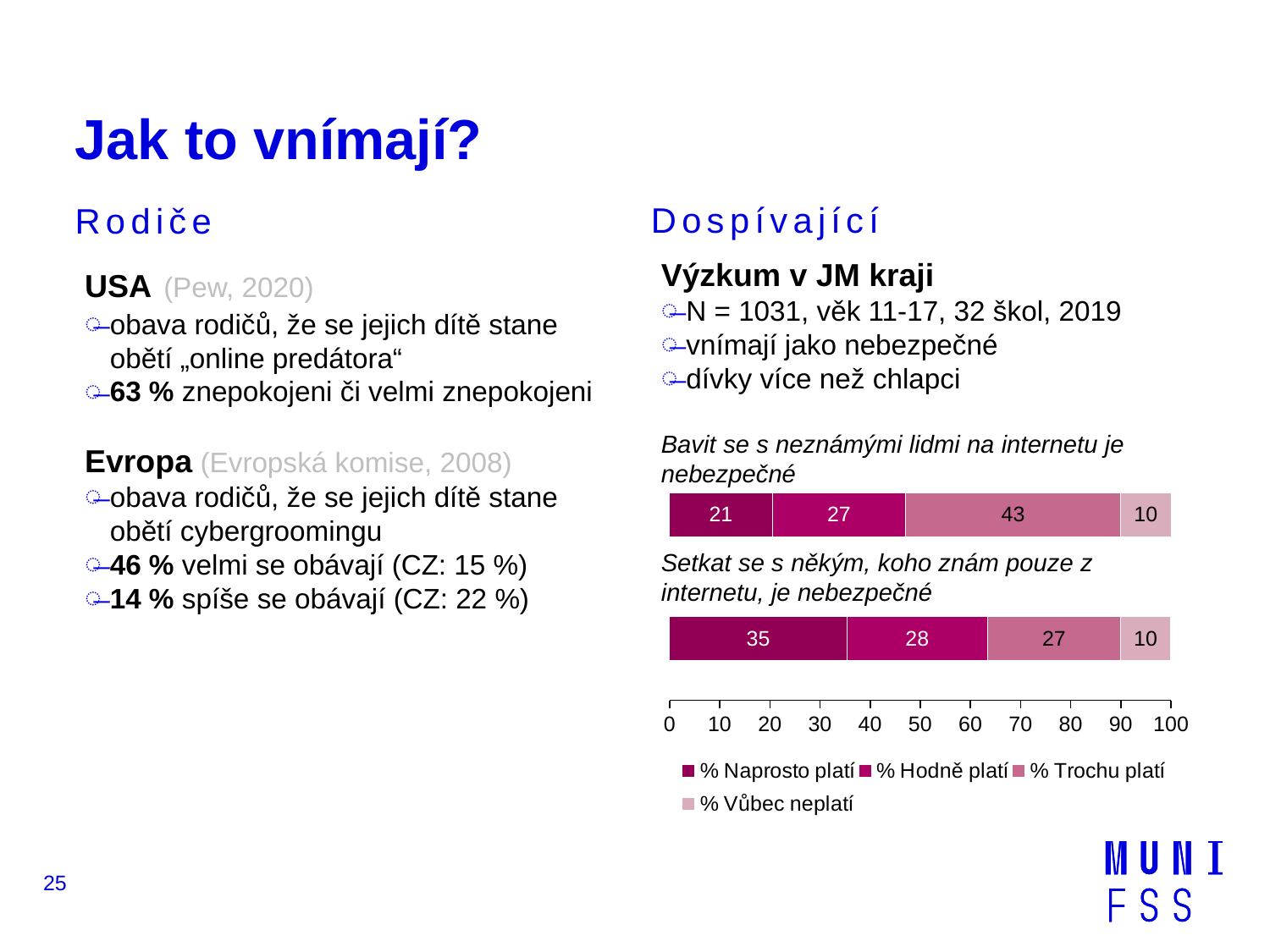
What is the difference between the "% Naprosto platí" values of the two statements (35 vs 21)? 14 What is the last entry listed in the chart legend? % Vůbec neplatí How many series does the chart legend list? 4 Which statement has the larger "% Trochu platí" value? Bavit se s neznámými lidmi na internetu je nebezpečné What is the value of "% Naprosto platí" for the statement "Setkat se s někým, koho znám pouze z internetu, je nebezpečné"? 35 How many bars (statements) does the chart show? 2 What is the value of "% Trochu platí" for the statement "Bavit se s neznámými lidmi na internetu je nebezpečné"? 43 What is the value of "% Naprosto platí" for the statement "Bavit se s neznámými lidmi na internetu je nebezpečné"? 21 What kind of chart is shown on the slide? stacked bar chart Which response category has the largest share for the statement "Bavit se s neznámými lidmi na internetu je nebezpečné"? % Trochu platí What is the value of "% Hodně platí" for the statement "Setkat se s někým, koho znám pouze z internetu, je nebezpečné"? 28 Which response category has the smallest share for the statement "Setkat se s někým, koho znám pouze z internetu, je nebezpečné"? % Vůbec neplatí